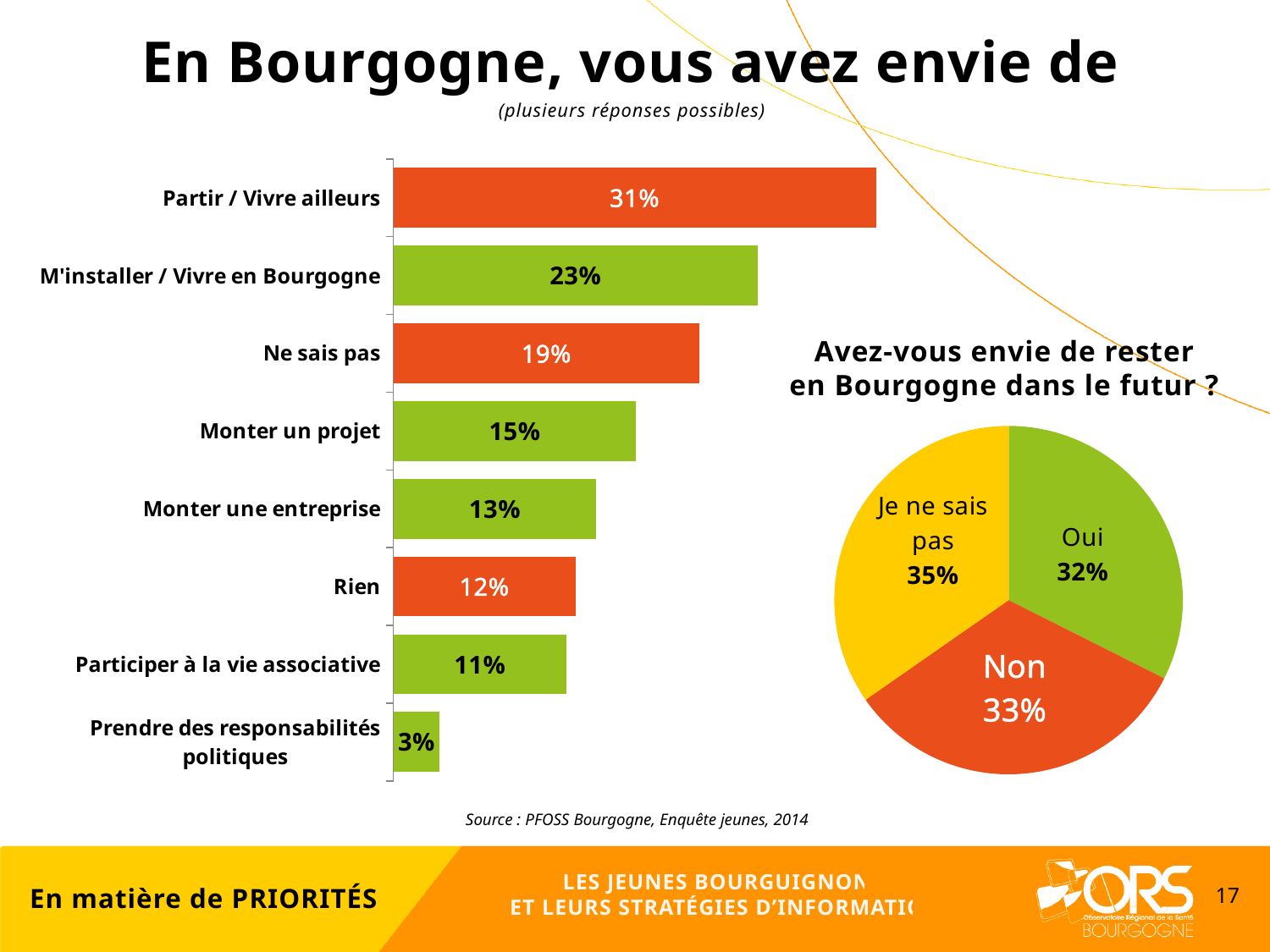
What kind of chart is the chart on the left of the slide? Bar chart In the bar chart on the left, which category has the lowest value? Prendre des responsabilités politiques How many categories does the bar chart on the left show? 8 In the pie chart "Avez-vous envie de rester en Bourgogne dans le futur ?", what share is "Non"? 33% How many slices does the pie chart "Avez-vous envie de rester en Bourgogne dans le futur ?" have? 3 In the bar chart on the left, what is the value for "Partir / Vivre ailleurs"? 31% In the bar chart on the left, what is the value for "Monter une entreprise"? 13% In the pie chart "Avez-vous envie de rester en Bourgogne dans le futur ?", which slice is the largest? Je ne sais pas In the bar chart on the left, what is the difference between "Partir / Vivre ailleurs" and "M'installer / Vivre en Bourgogne"? 8% In the bar chart on the left, which is larger: "Monter un projet" or "Rien"? Monter un projet In the pie chart "Avez-vous envie de rester en Bourgogne dans le futur ?", what is the difference between "Je ne sais pas" and "Oui"? 3% In the bar chart on the left, which category has the highest value? Partir / Vivre ailleurs